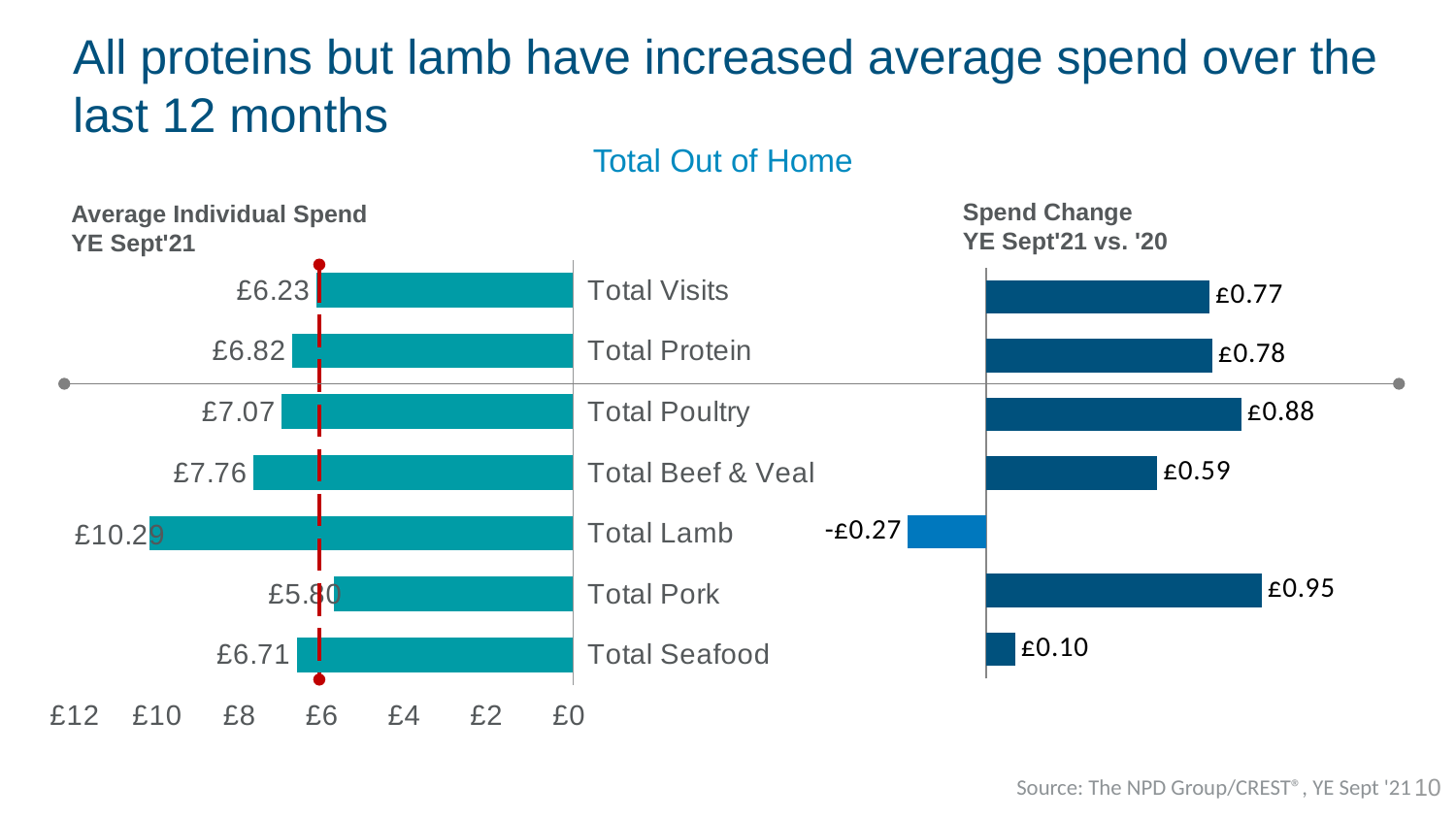
In the Spend Change YE Sept'21 vs. '20 chart, what is the value for Total Poultry? £0.88 In the Average Individual Spend YE Sept'21 chart, what is the value for Total Lamb? £10.29 How many categories are shown in the Average Individual Spend YE Sept'21 chart? 7 In the Spend Change YE Sept'21 vs. '20 chart, what is the value for Total Lamb? -£0.27 In the Average Individual Spend YE Sept'21 chart, which category has the lowest value? Total Pork In the Average Individual Spend YE Sept'21 chart, what is the difference between Total Lamb and Total Pork? £4.49 In the Average Individual Spend YE Sept'21 chart, what is the value for Total Pork? £5.80 In the Spend Change YE Sept'21 vs. '20 chart, which category has the highest value? Total Pork In the Spend Change YE Sept'21 vs. '20 chart, which category has the lowest value? Total Lamb In the Spend Change YE Sept'21 vs. '20 chart, which is larger, Total Beef & Veal or Total Seafood? Total Beef & Veal What type of chart is the Spend Change YE Sept'21 vs. '20 chart? Bar chart In the Average Individual Spend YE Sept'21 chart, which category has the highest value? Total Lamb